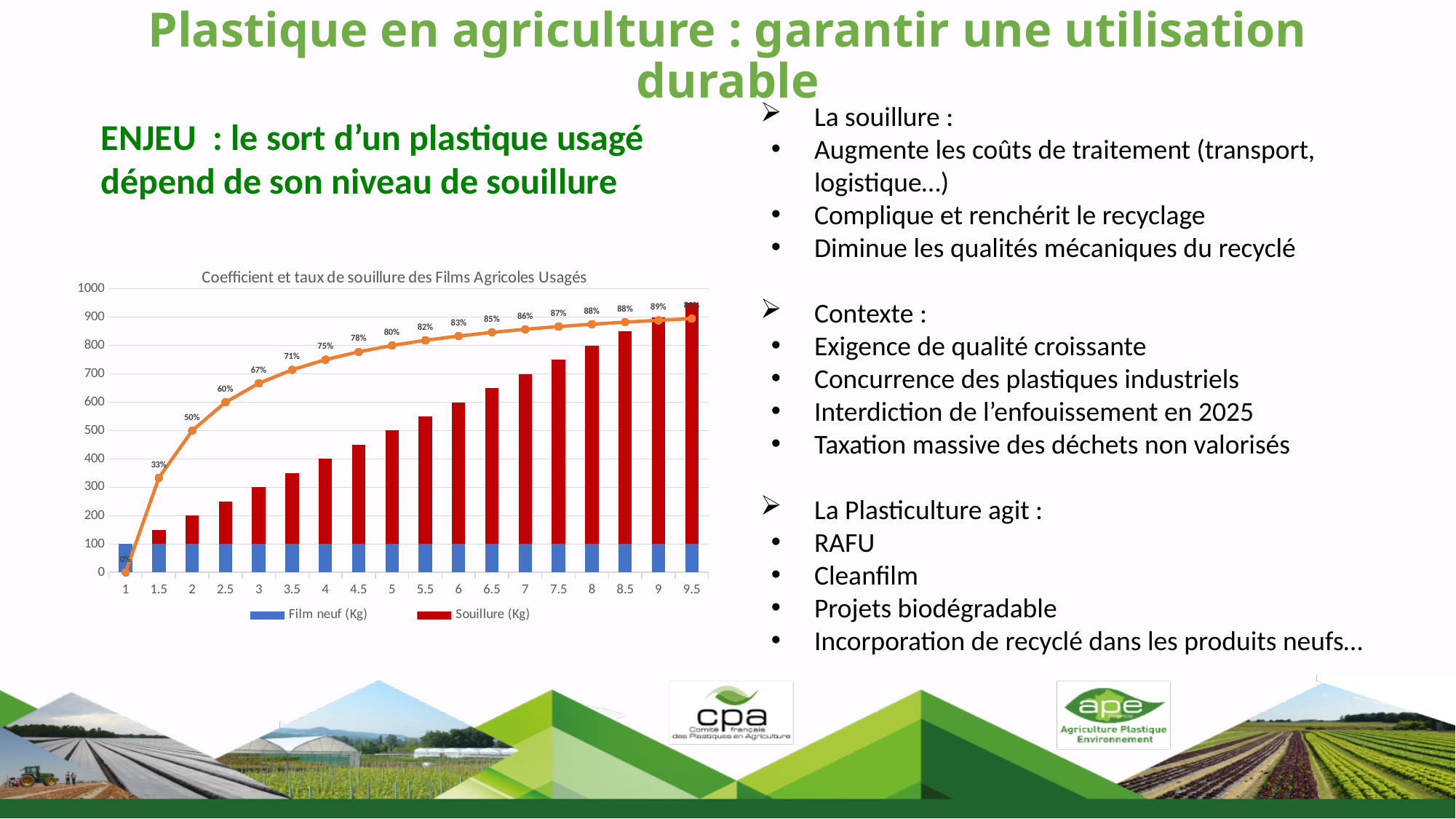
Which category has the tallest stacked bar? 9.5 What percentage is labelled on the line at x = 2? 50% Does the orange line rise or fall as x increases? rises What percentage is labelled on the line at x = 1? 0% What percentage is labelled on the line at x = 3.5? 71% Is the total height of the stacked bar at x = 9.5 greater or less than 900? greater What percentage is labelled on the line at x = 9? 89% What kind of chart is shown on the slide? combination bar and line chart What is the title of the chart? Coefficient et taux de souillure des Films Agricoles Usagés Which category has the shortest stacked bar? 1 How many categories are shown on the x axis of the chart? 18 How many series does the chart legend list? 2